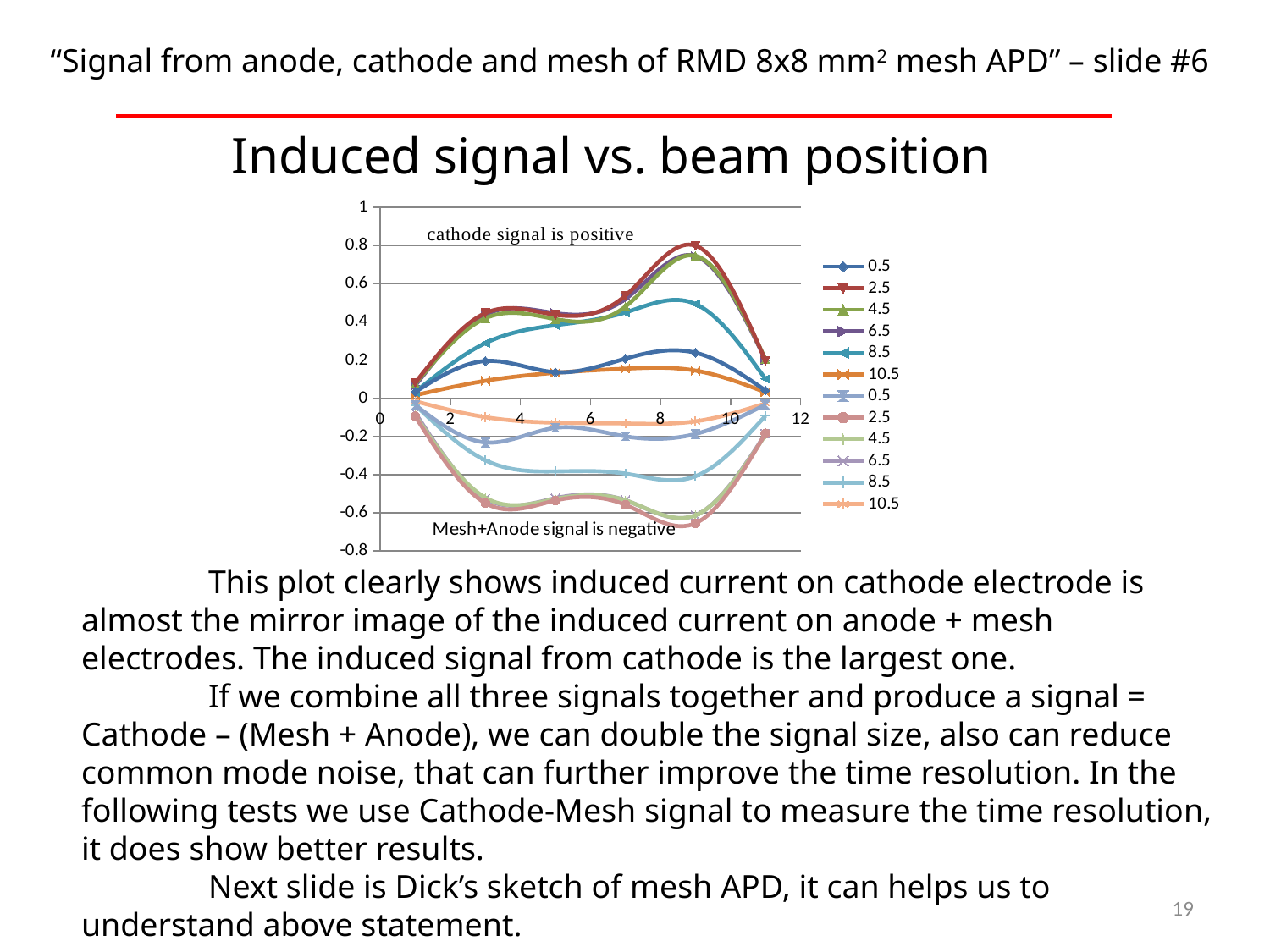
Is the highest point plotted on the chart greater or less than 1? less How many series does the chart's legend list? 12 Is the highest point plotted on the chart greater or less than 0.6? greater Do the negative (mesh+anode) curves rise or fall between x = 10 and x = 11? rise Is the lowest point plotted on the chart greater or less than -0.8? greater What annotation is written in the upper part of the plot area? cathode signal is positive How many legend entries are labelled 10.5? 2 What is the title of the chart? Induced signal vs. beam position What kind of chart is shown on the slide? line chart Do the positive (cathode) curves rise or fall between x = 10 and x = 11? fall